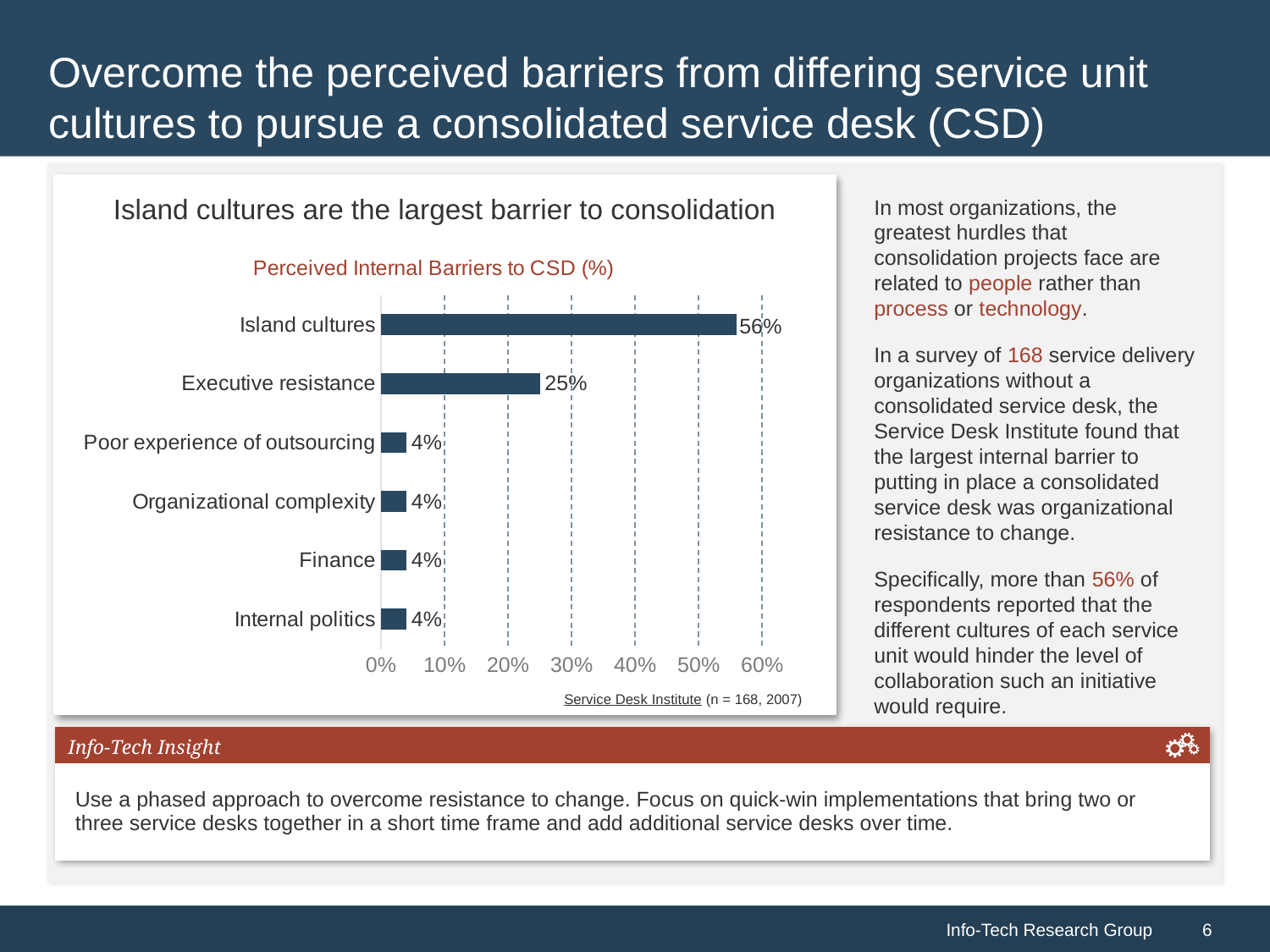
How many categories are shown in the chart? 6 What is the difference between the values for Island cultures and Executive resistance? 31% Which is larger, the value for Executive resistance or the value for Finance? Executive resistance What kind of chart is shown? Bar chart What is the difference between the values for Executive resistance and Organizational complexity? 21% Which category has the highest value? Island cultures What is the value for Island cultures? 56% Is the value for Executive resistance greater or less than 20%? greater What is the title of the chart? Perceived Internal Barriers to CSD (%) What is the value for Internal politics? 4% What is the sample size (n) cited in the chart's source note? 168 What is the value for Executive resistance? 25%